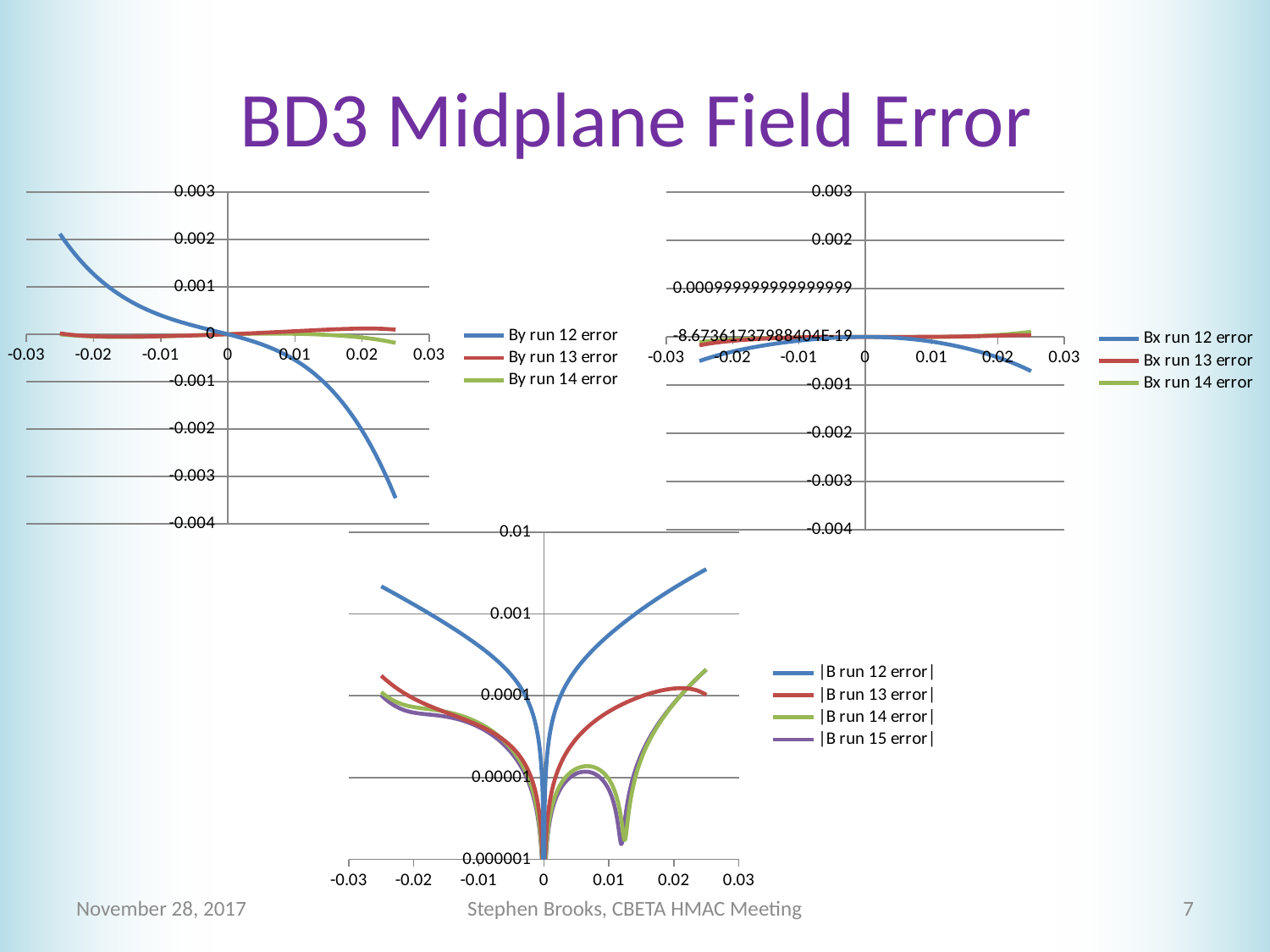
How many series does the legend of the bottom chart (|B run error|) list? 4 In the bottom chart, is the value of |B run 12 error| at x = 0.025 greater or less than 0.001? greater In the bottom chart, which series has the highest value at x = 0.025? |B run 12 error| How many series does the legend of the top-left chart (By run errors) list? 3 In the top-left chart, is the value of By run 12 error at x = 0.025 greater or less than -0.003? less How many charts are shown on the slide? 3 How many series does the legend of the top-right chart (Bx run errors) list? 3 In the top-left chart, is the value of By run 12 error at x = -0.025 greater or less than 0.001? greater In the top-left chart, does the By run 12 error line rise or fall as x increases from -0.03 to 0.03? fall What kind of chart is the top-left chart (By run errors)? line chart What is the title of the slide containing the charts? BD3 Midplane Field Error